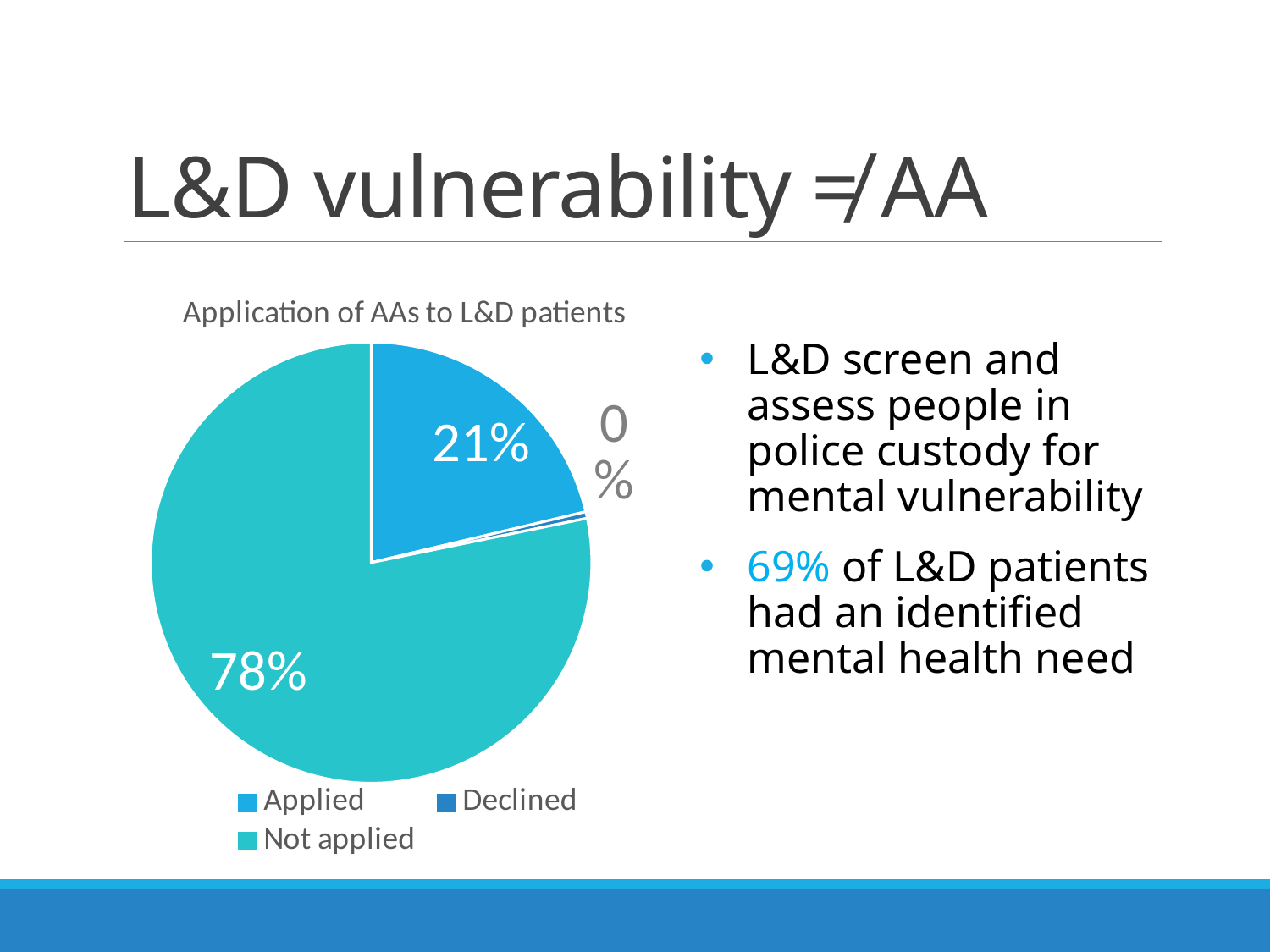
What percentage of L&D patients had an AA not applied? 78% Which category has the largest share of the pie? Not applied What percentage of L&D patients had an AA applied? 21% How many categories does the legend list? 3 What percentage is shown for the Declined slice? 0% Which is larger, the Applied slice or the Not applied slice? Not applied Which legend entry is shown in the teal colour? Not applied What kind of chart is shown on the slide? pie chart Which category has the smallest share of the pie? Declined What is the title of the chart? Application of AAs to L&D patients What is the difference in percentage points between Not applied and Applied? 57